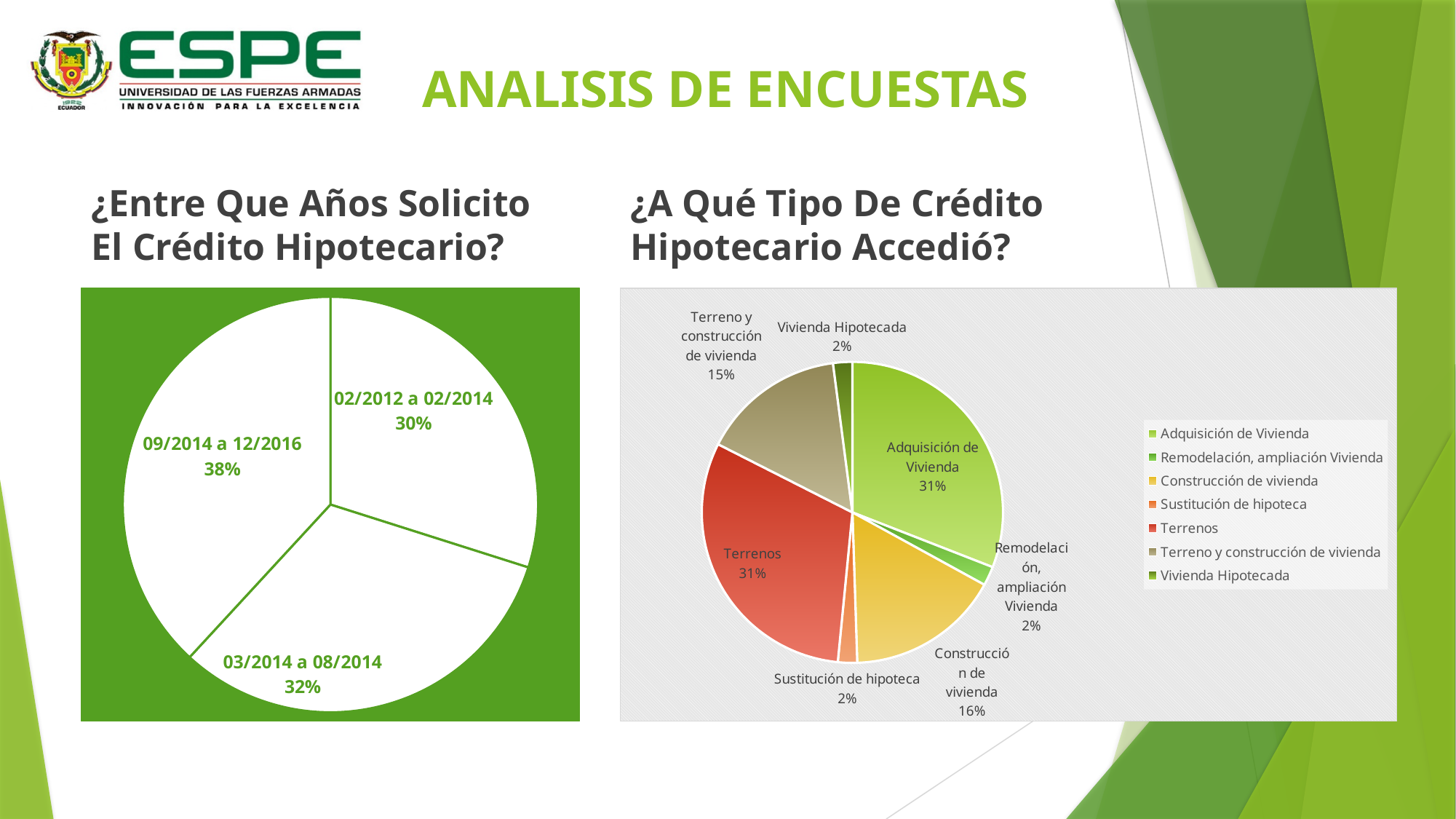
In the left pie chart (¿Entre Que Años Solicito El Crédito Hipotecario?), what is the difference in percentage points between 09/2014 a 12/2016 and 02/2012 a 02/2014? 8 In the left pie chart (¿Entre Que Años Solicito El Crédito Hipotecario?), what share is shown for 02/2012 a 02/2014? 30% In the left pie chart (¿Entre Que Años Solicito El Crédito Hipotecario?), which period has the largest share? 09/2014 a 12/2016 In the left pie chart (¿Entre Que Años Solicito El Crédito Hipotecario?), what share is shown for 09/2014 a 12/2016? 38% In the right pie chart (¿A Qué Tipo De Crédito Hipotecario Accedió?), how many categories does the legend list? 7 In the right pie chart (¿A Qué Tipo De Crédito Hipotecario Accedió?), what share is shown for Terrenos? 31% In the left pie chart (¿Entre Que Años Solicito El Crédito Hipotecario?), how many slices does the pie have? 3 In the right pie chart (¿A Qué Tipo De Crédito Hipotecario Accedió?), which is larger, Construcción de vivienda or Terreno y construcción de vivienda? Construcción de vivienda In the right pie chart (¿A Qué Tipo De Crédito Hipotecario Accedió?), what is the difference in percentage points between Adquisición de Vivienda and Sustitución de hipoteca? 29 What type of chart is used on the left side of the slide? Pie chart In the right pie chart (¿A Qué Tipo De Crédito Hipotecario Accedió?), what share is shown for Terreno y construcción de vivienda? 15% In the right pie chart (¿A Qué Tipo De Crédito Hipotecario Accedió?), what share is shown for Construcción de vivienda? 16%